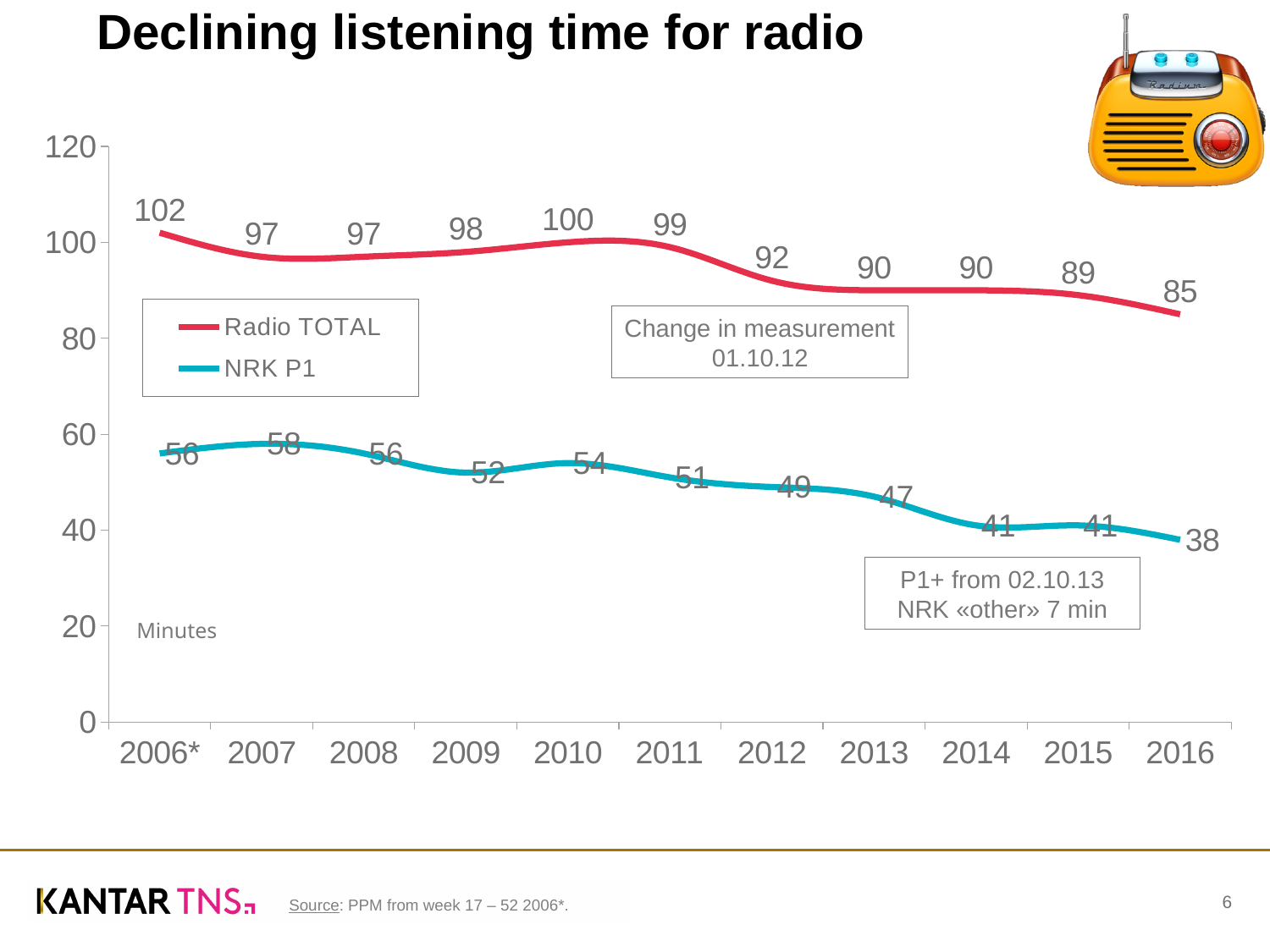
In which year is the Radio TOTAL value highest? 2006* How many series does the legend list? 2 What is the difference between the Radio TOTAL value in 2006* and in 2016? 17 What is the NRK P1 value for 2010? 54 What unit is indicated for the values on the chart? Minutes What type of chart is shown on the slide? Line chart In which year is the NRK P1 value lowest? 2016 What is the Radio TOTAL value for 2016? 85 How many years are shown on the x axis? 11 Does the NRK P1 series generally rise or fall from 2006* to 2016? Fall What is the Radio TOTAL value for 2012? 92 Which is larger in 2013: the Radio TOTAL value or the NRK P1 value? Radio TOTAL